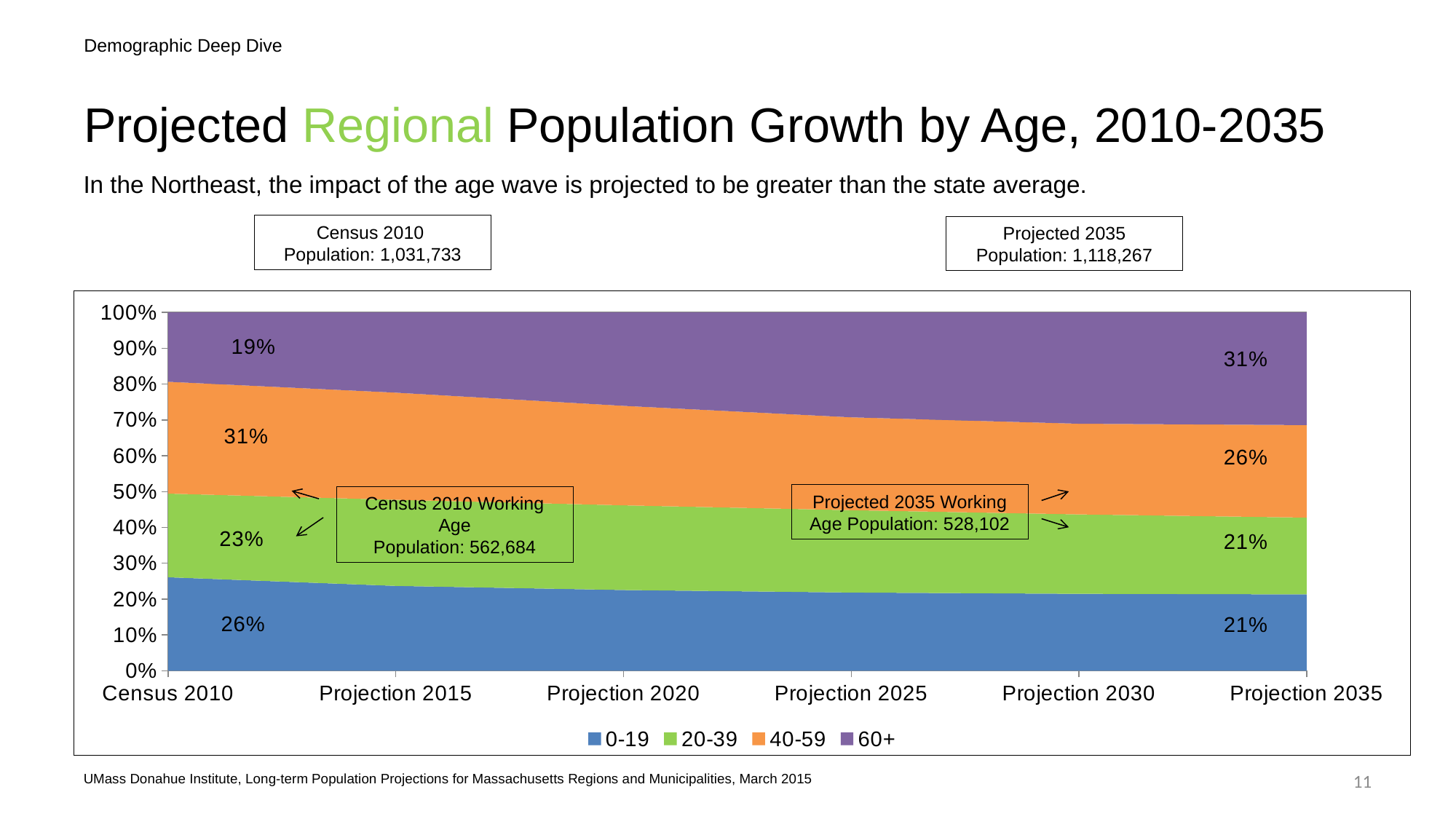
Which age group has the largest share in Census 2010? 40-59 What kind of chart is shown on the slide? Stacked area chart What share of the population is aged 40-59 in Projection 2035? 26% Is the 0-19 share larger in Census 2010 or in Projection 2035? Census 2010 What share of the population is aged 0-19 in Census 2010? 26% How many time points are shown on the x axis? 6 Which age group has the largest share in Projection 2035? 60+ How many series does the legend list? 4 Which age group has the smallest share in Census 2010? 60+ By how many percentage points does the 60+ share change from Census 2010 to Projection 2035? 12 percentage points What share of the population is aged 60+ in Census 2010? 19% What share of the population is projected to be aged 60+ in Projection 2035? 31%